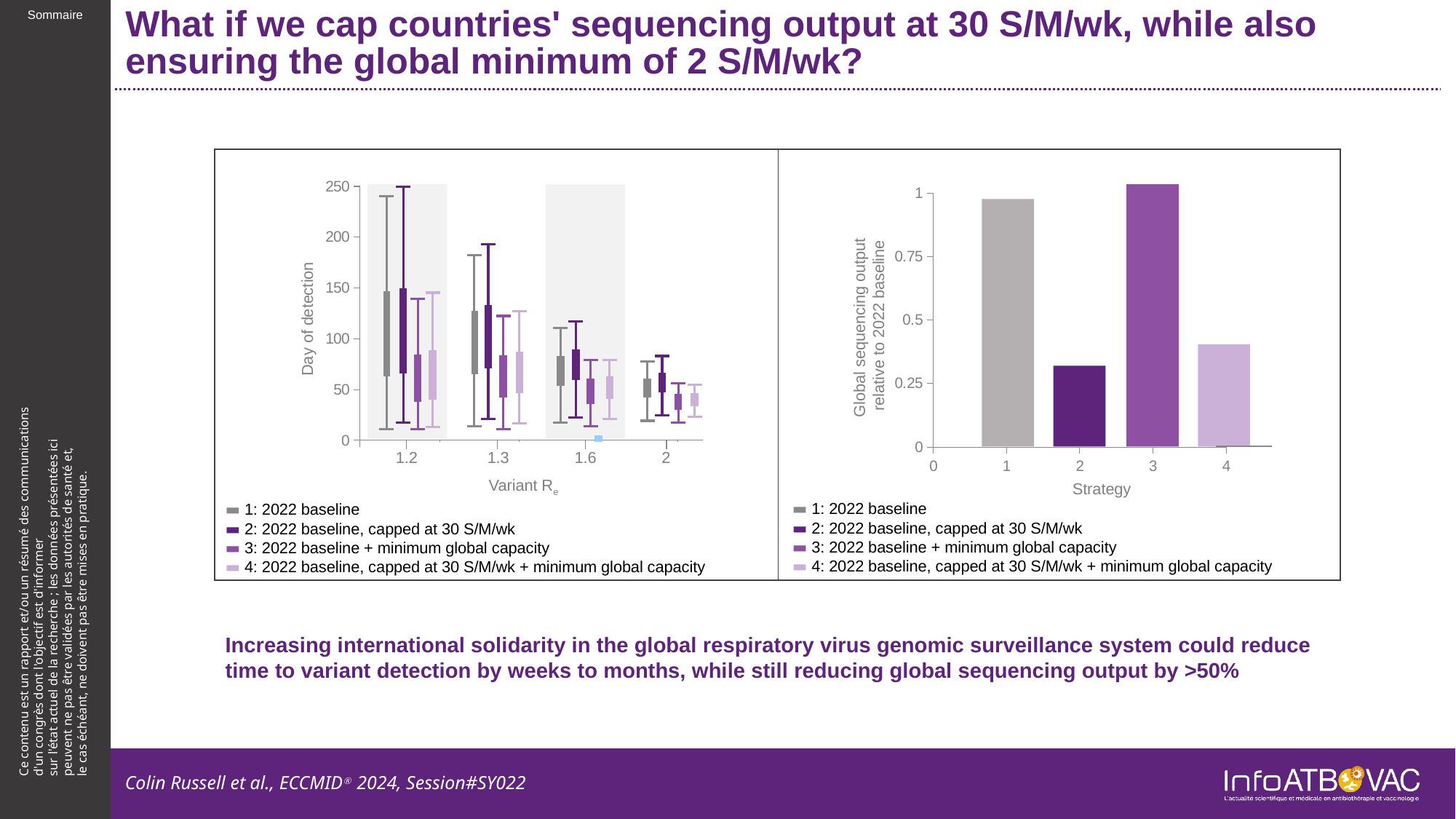
What kind of chart is the right-hand chart (Global sequencing output relative to 2022 baseline)? bar chart What kind of chart is the left-hand chart (Day of detection vs Variant Re)? box plot How many strategies (bars) are plotted in the right-hand chart? 4 In the right-hand chart, is the value for strategy 1 greater or less than 0.75? greater In the right-hand chart, which has the larger value: strategy 3 or strategy 2? Strategy 3 In the right-hand chart, which strategy has the lowest global sequencing output relative to the 2022 baseline? Strategy 2 In the left-hand chart, does the day of detection for the 2022 baseline rise or fall as Variant Re increases from 1.2 to 2? fall In the right-hand chart, is the value for strategy 4 greater or less than 0.5? less How many Variant Re categories are shown on the x axis of the left-hand chart? 4 In the right-hand chart, which has the larger value: strategy 2 or strategy 4? Strategy 4 How many series does the legend of the left-hand chart list? 4 In the right-hand chart, is the value for strategy 2 greater or less than 0.5? less